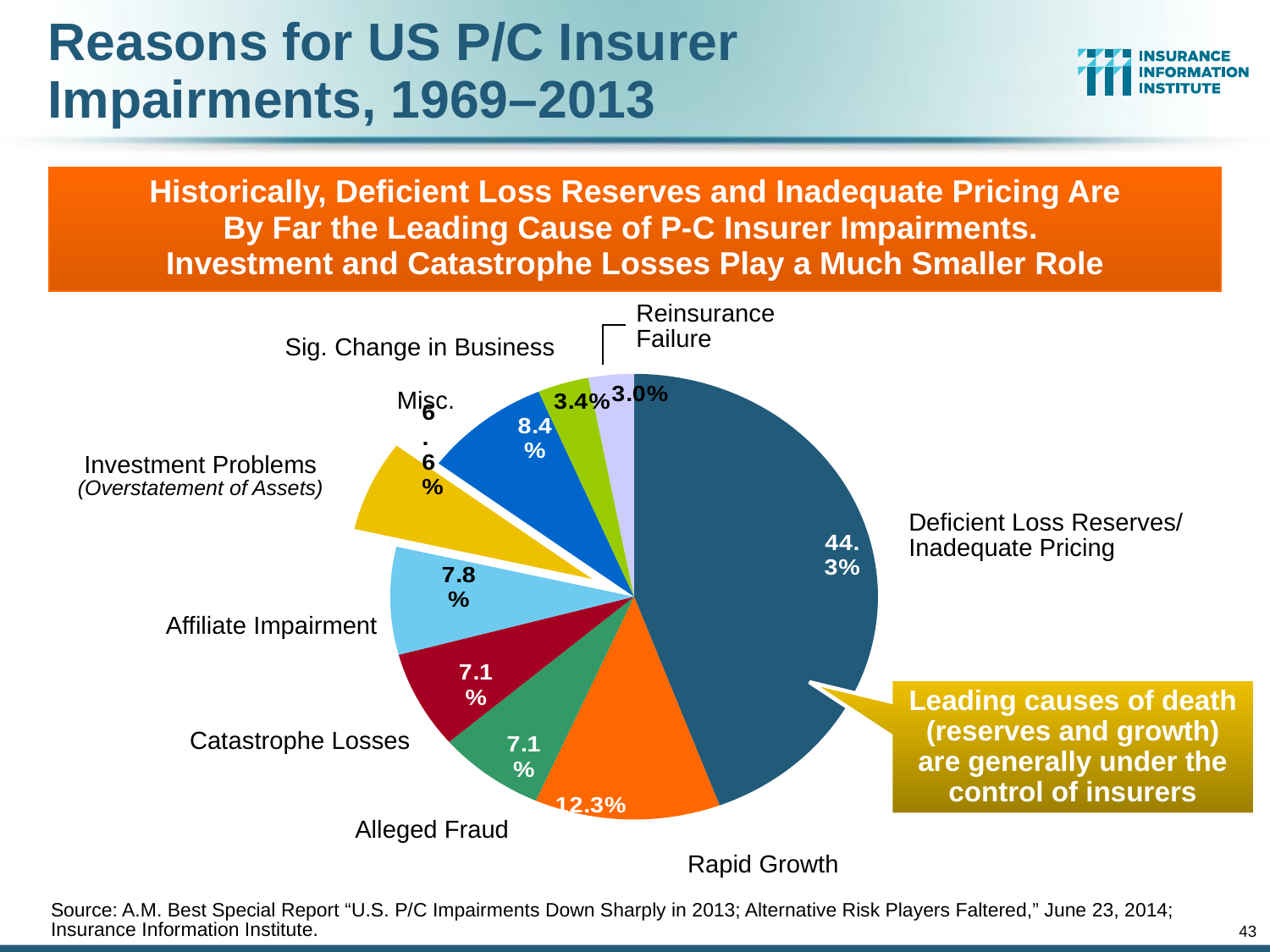
What share of impairments is attributed to Deficient Loss Reserves/Inadequate Pricing? 44.3% Which reason accounts for the smallest share of impairments? Reinsurance Failure What percentage of impairments is attributed to Sig. Change in Business? 3.4% What percentage of impairments is attributed to Rapid Growth? 12.3% What kind of chart is shown on the slide? Pie chart Which is larger: the share for Affiliate Impairment or the share for Catastrophe Losses? Affiliate Impairment Which reason accounts for the largest share of US P/C insurer impairments? Deficient Loss Reserves/Inadequate Pricing What percentage of impairments is attributed to Affiliate Impairment? 7.8% What percentage of impairments is attributed to Catastrophe Losses? 7.1% What is the title of the slide containing the pie chart? Reasons for US P/C Insurer Impairments, 1969–2013 How many categories (slices) does the pie chart have? 9 What is the difference in percentage points between Deficient Loss Reserves/Inadequate Pricing and Rapid Growth? 32.0 percentage points